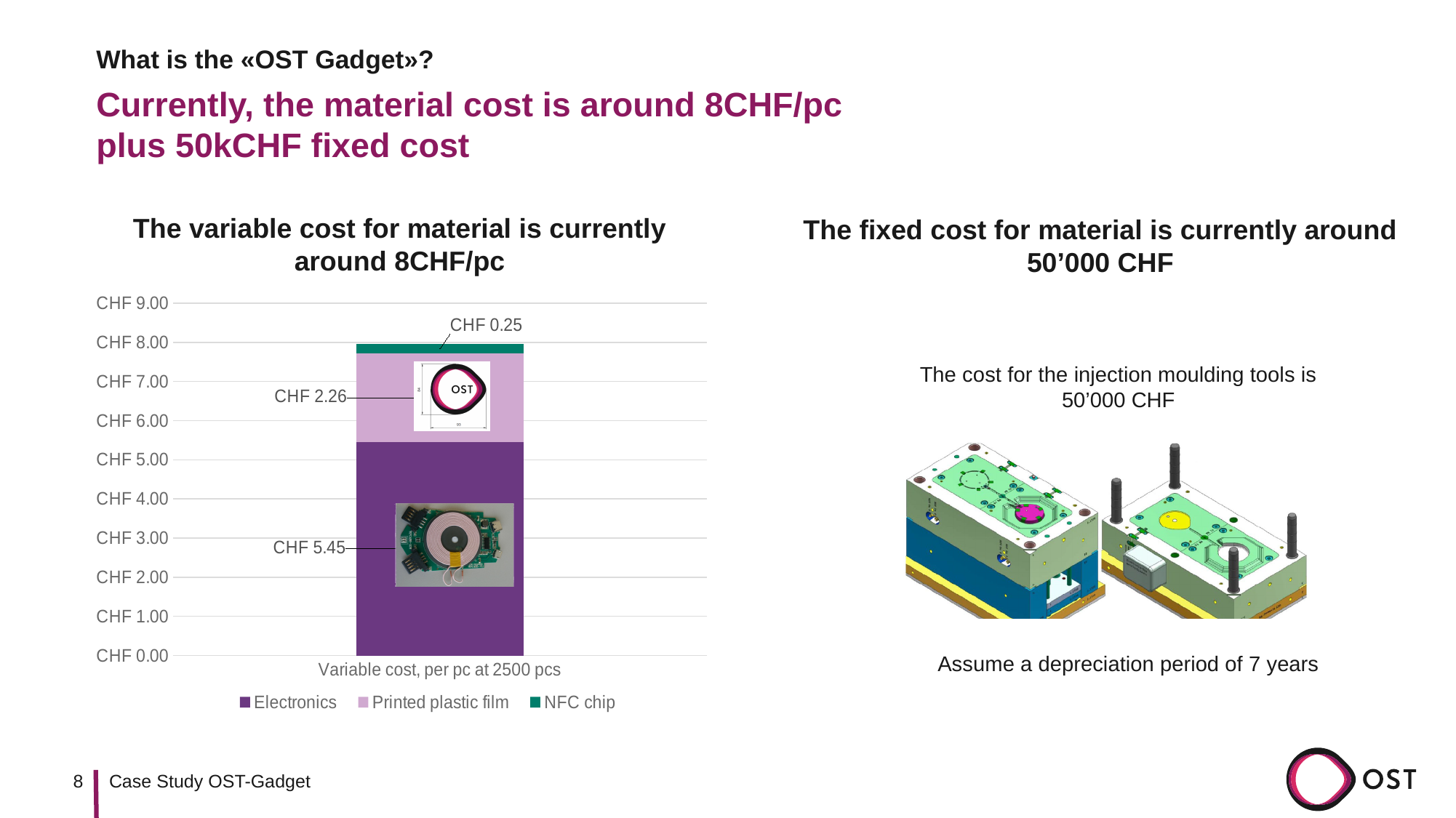
Which is larger, the Printed plastic film value or the NFC chip value? Printed plastic film What is the value for Electronics in the variable cost bar? CHF 5.45 What is the value for Printed plastic film in the variable cost bar? CHF 2.26 How many series does the legend list? 3 What is the category label on the x axis of the chart? Variable cost, per pc at 2500 pcs What is the value for NFC chip in the variable cost bar? CHF 0.25 What is the difference between the Electronics value and the Printed plastic film value? CHF 3.19 Is the total height of the stacked bar greater or less than CHF 8.00? less What is the total of the stacked bar for Variable cost, per pc at 2500 pcs? CHF 7.96 Which series has the smallest value in the stacked bar? NFC chip What kind of chart is shown on the slide? Stacked bar chart Which series has the largest value in the stacked bar? Electronics